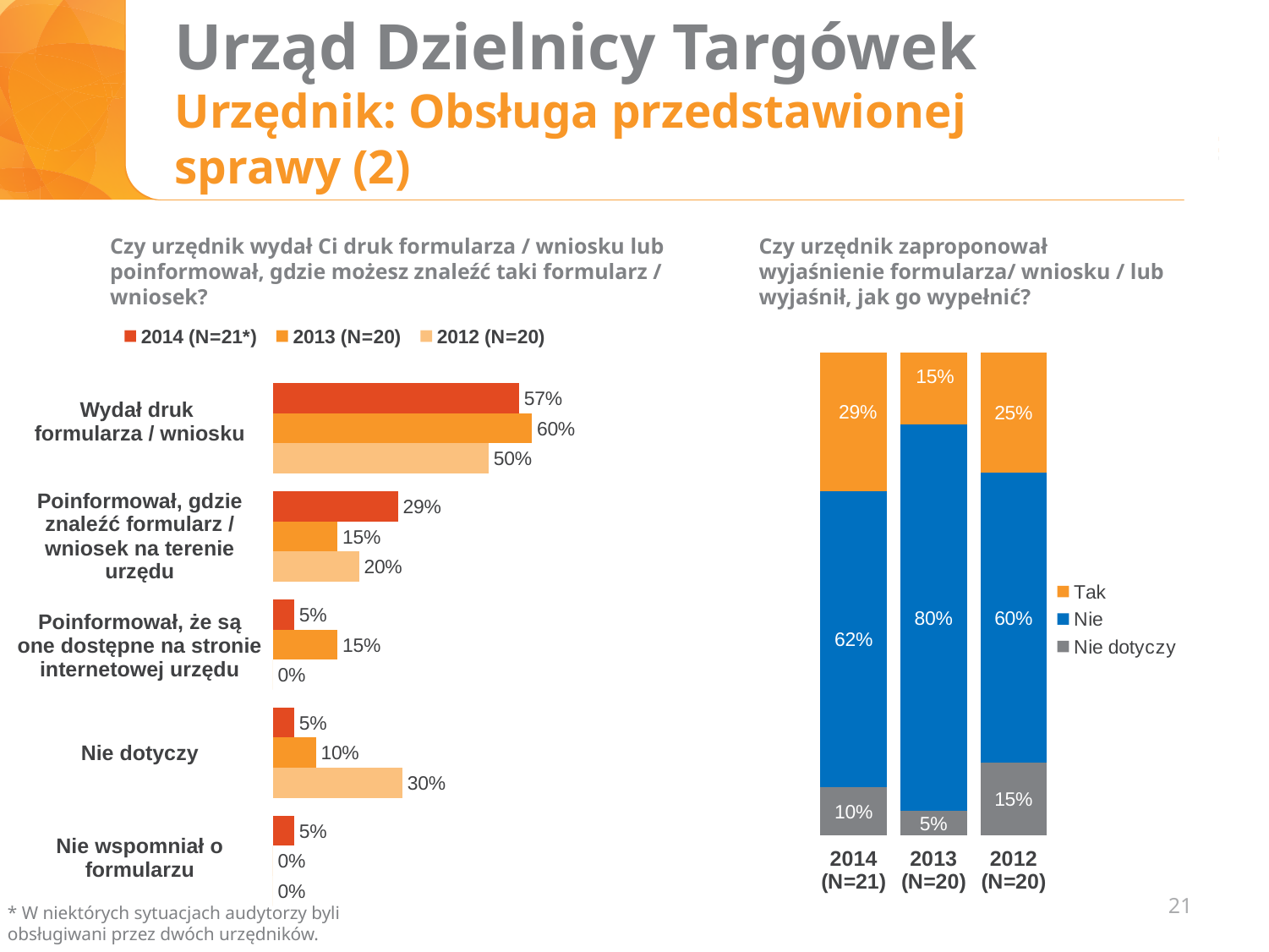
In the left chart, what is the 2012 (N=20) value for "Nie dotyczy"? 30% How many series does the legend of the left chart list? 3 In the right chart, what is the difference between the "Nie dotyczy" values for 2012 and 2013? 10 percentage points In the right chart, what is the "Nie" value for 2013 (N=20)? 80% In the left chart, which category has the highest 2013 (N=20) value? Wydał druk formularza / wniosku In the left chart, which is larger for "Nie dotyczy": the 2013 value or the 2012 value? 2012 How many categories are shown in the left chart? 5 In the right chart, which year has the highest "Tak" value? 2014 (N=21) In the left chart, what is the difference between the 2014 and 2013 values for "Poinformował, gdzie znaleźć formularz / wniosek na terenie urzędu"? 14 percentage points In the right chart, what is the total of the stacked bar for 2013 (N=20)? 100% What type of chart is the left chart? Bar chart In the left chart, what is the 2014 (N=21*) value for "Wydał druk formularza / wniosku"? 57%